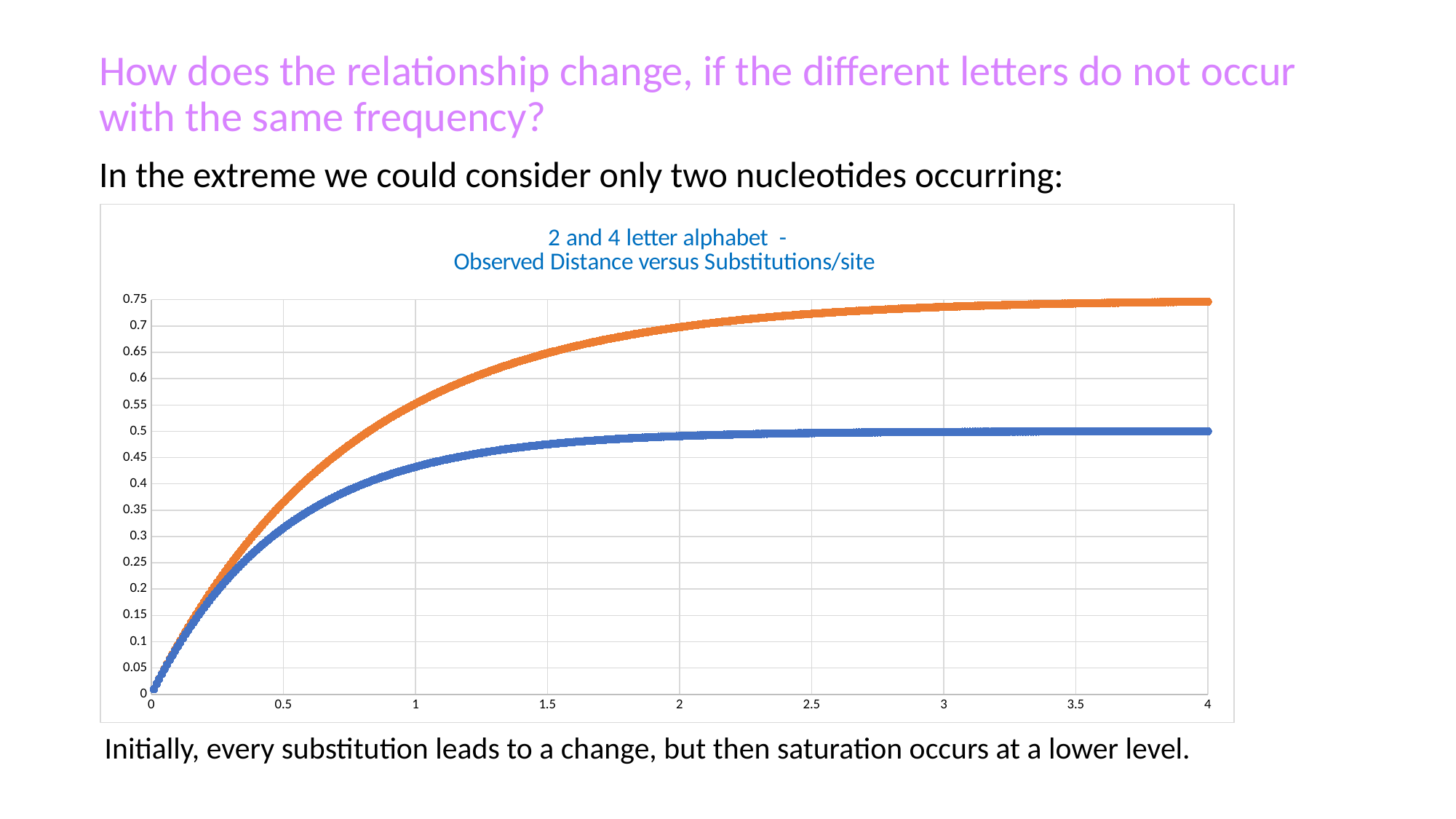
What is the highest value labelled on the y axis? 0.75 At x = 2, which series has the higher value, the orange series or the blue series? the orange series At x = 1, is the value of the blue series greater or less than 0.5? less At x = 4, is the value of the orange series greater or less than 0.7? greater At x = 4, is the value of the blue series greater or less than 0.55? less How many data series are plotted in the chart? 2 Do the values of the orange series rise or fall as the x axis increases? rise What kind of chart is shown on the slide? line chart Do the values of the blue series rise or fall as the x axis increases? rise What is the title of the chart? 2 and 4 letter alphabet - Observed Distance versus Substitutions/site